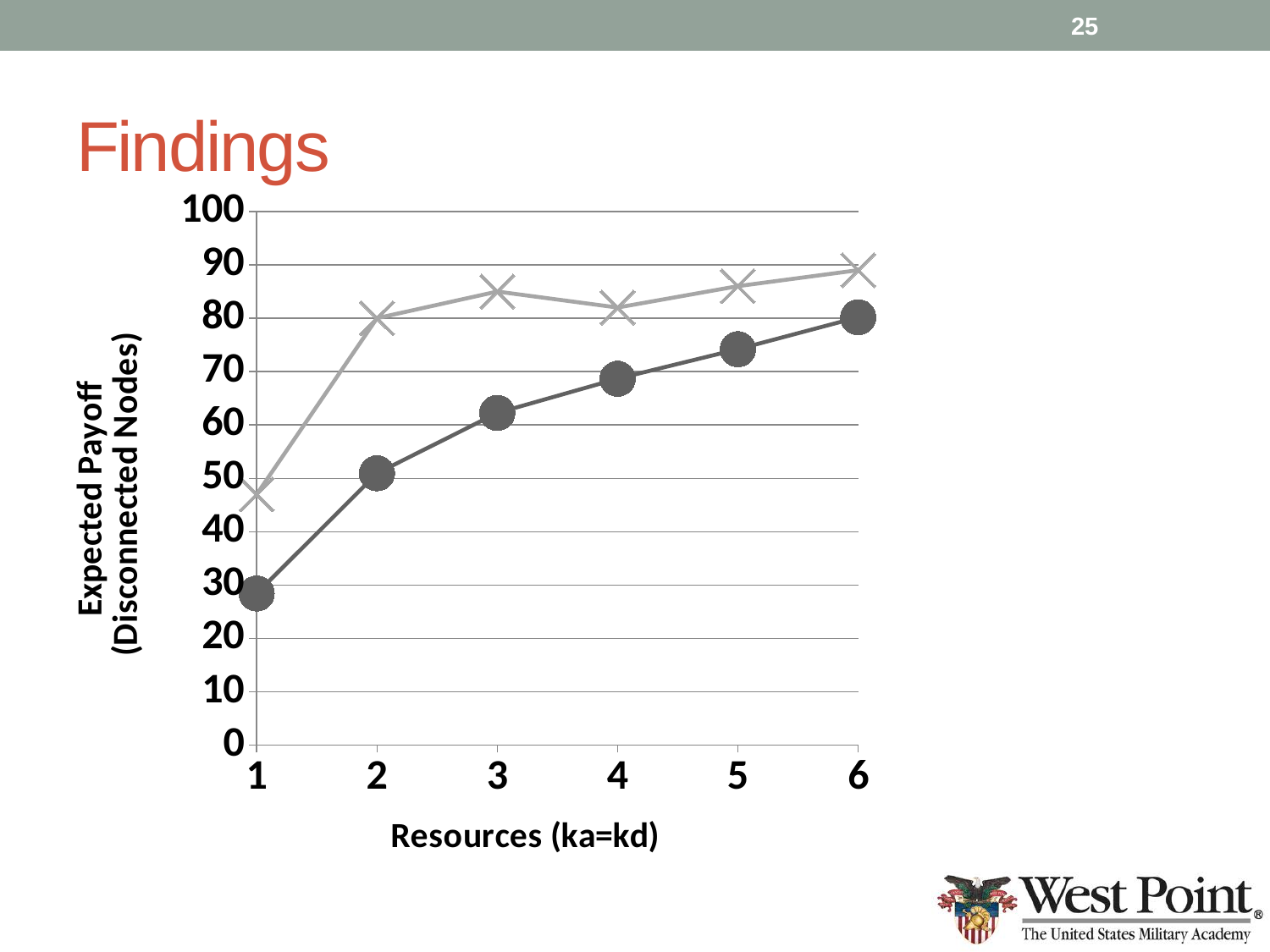
At Resources = 3, which series has the higher value, the circle-marker series or the X-marker series? the X-marker series How many data series are plotted on the chart? 2 What is the title of the y axis? Expected Payoff (Disconnected Nodes) At Resources = 1, is the value of the circle-marker series greater or less than 40? less What kind of chart is shown on the slide? line chart At Resources = 2, is the value of the circle-marker series greater or less than 60? less At which Resources value does the circle-marker series reach its highest value? 6 Does the series with circle markers rise or fall as Resources increase from 1 to 6? rise At Resources = 6, is the value of the X-marker series greater or less than 80? greater At which Resources value does the X-marker series have its lowest value? 1 How many points along the x axis (Resources values) does each series have? 6 What is the title of the x axis? Resources (ka=kd)